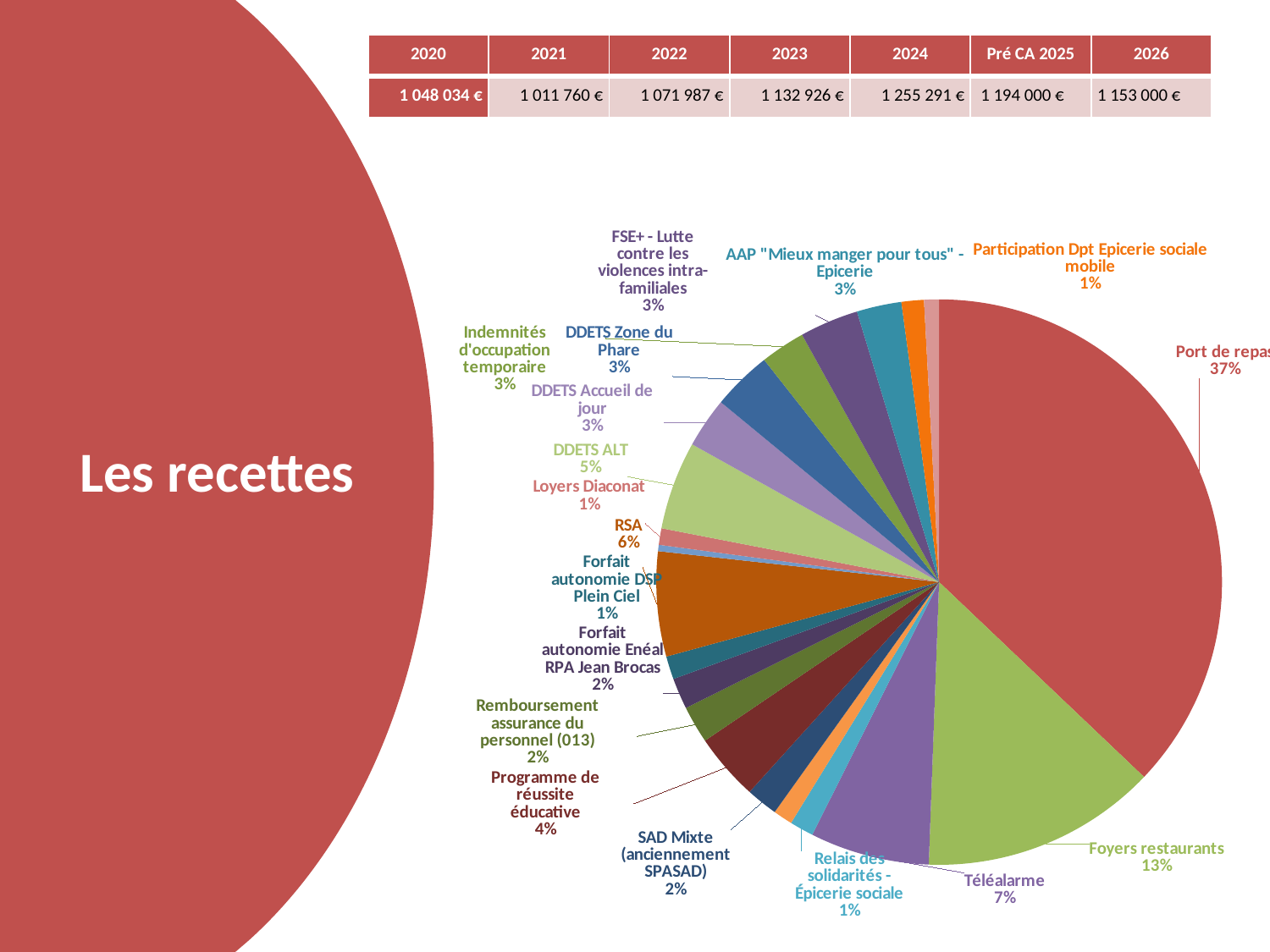
What percentage is shown for DDETS ALT? 5% How many slices does the pie chart have? 21 What percentage is shown for Foyers restaurants? 13% What percentage is shown for Téléalarme? 7% What share of the pie does Port de repas represent? 37% Which is larger, the share for Téléalarme or the share for RSA? Téléalarme What percentage is shown for RSA? 6% What percentage is shown for Programme de réussite éducative? 4% What is the difference in percentage points between Port de repas and Foyers restaurants? 24 What kind of chart is shown on the slide? pie chart What is the title of the slide containing the pie chart? Les recettes Which category has the largest share of the pie chart? Port de repas